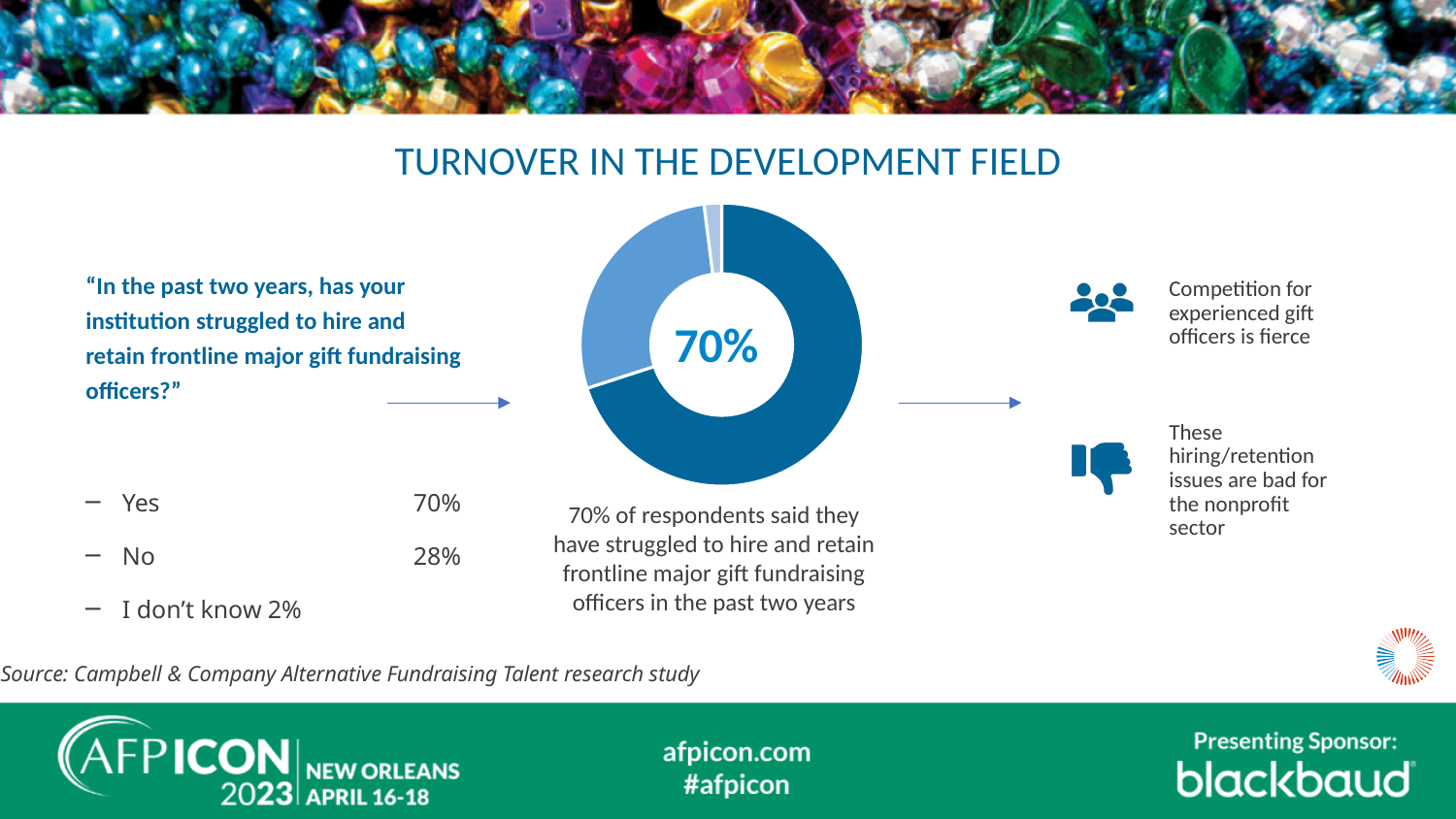
What kind of chart is shown on the slide? Donut (pie) chart What is the combined share of the "No" and "I don't know" responses? 30% What share of respondents answered "Yes"? 70% Which is larger, the share for "No" or the share for "I don't know"? No Which response has the smallest slice of the donut chart? I don't know What share of respondents answered "I don't know"? 2% What percentage is printed in the center of the donut chart? 70% What is the difference in percentage points between the "Yes" and "No" responses? 42 What share of respondents answered "No"? 28% Which response has the largest slice of the donut chart? Yes What is the title of the slide containing the chart? TURNOVER IN THE DEVELOPMENT FIELD How many slices does the donut chart have? 3